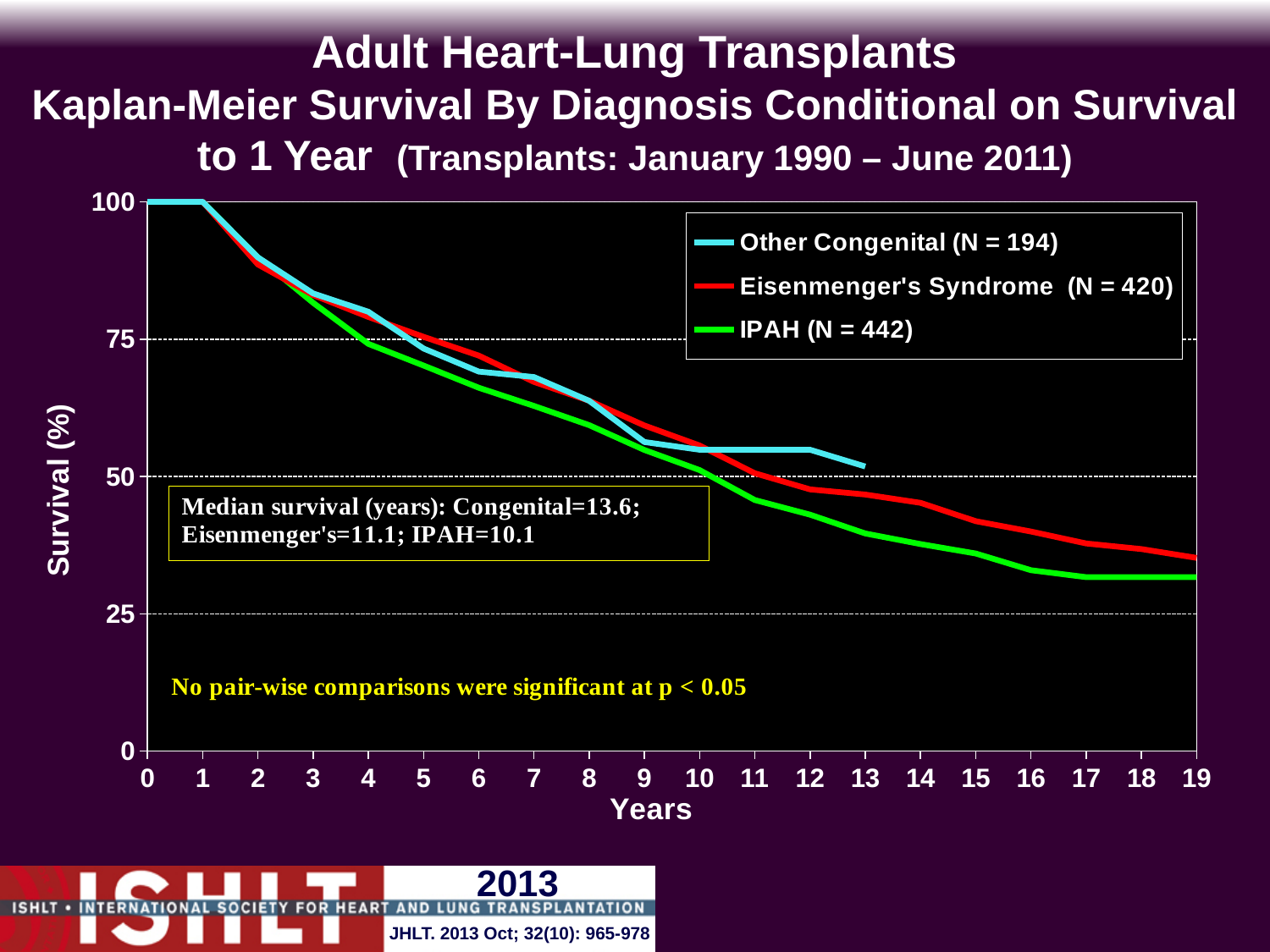
How many series does the legend list? 3 What kind of chart is shown on the slide? line chart According to the legend, what is the N for the IPAH series? 442 What is the median survival in years for IPAH, as stated in the text box? 10.1 Is the survival value for IPAH at 15 years greater or less than 50? less At 15 years, which series has the higher survival: Eisenmenger's Syndrome or IPAH? Eisenmenger's Syndrome Is the survival value for Other Congenital at 12 years greater or less than 50? greater Which diagnosis group has the longest median survival according to the text box? Congenital Do the survival curves rise or fall as the years increase along the x axis? fall What is the median survival in years for Congenital, as stated in the text box? 13.6 What is the difference in median survival (years) between Congenital and IPAH? 3.5 According to the legend, what is the N for the Eisenmenger's Syndrome series? 420